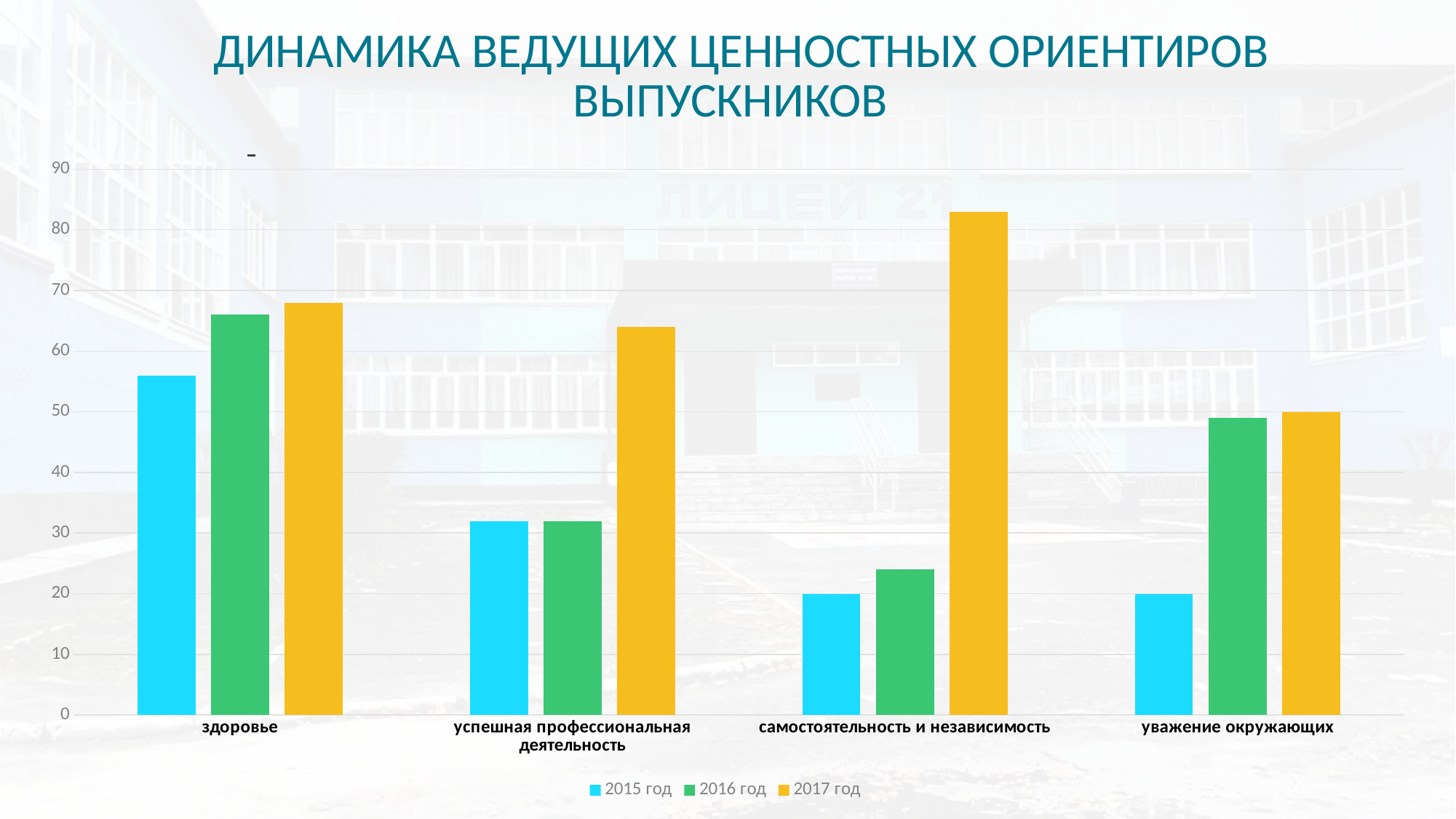
Which is larger for 2016 год: здоровье or уважение окружающих? здоровье How many categories are shown on the x axis? 4 What kind of chart is shown on the slide? bar chart What is the value for 2015 год in the category самостоятельность и независимость? 20 What is the value for 2017 год in the category уважение окружающих? 50 How many series does the legend list? 3 Which series is shown in yellow in the legend? 2017 год For самостоятельность и независимость, do the values rise or fall from 2015 год to 2017 год? rise Is the value for 2016 год in здоровье greater or less than 60? greater Which category has the highest value for 2017 год? самостоятельность и независимость Which category has the lowest value for 2016 год? самостоятельность и независимость Is the value for 2017 год in самостоятельность и независимость greater or less than 80? greater